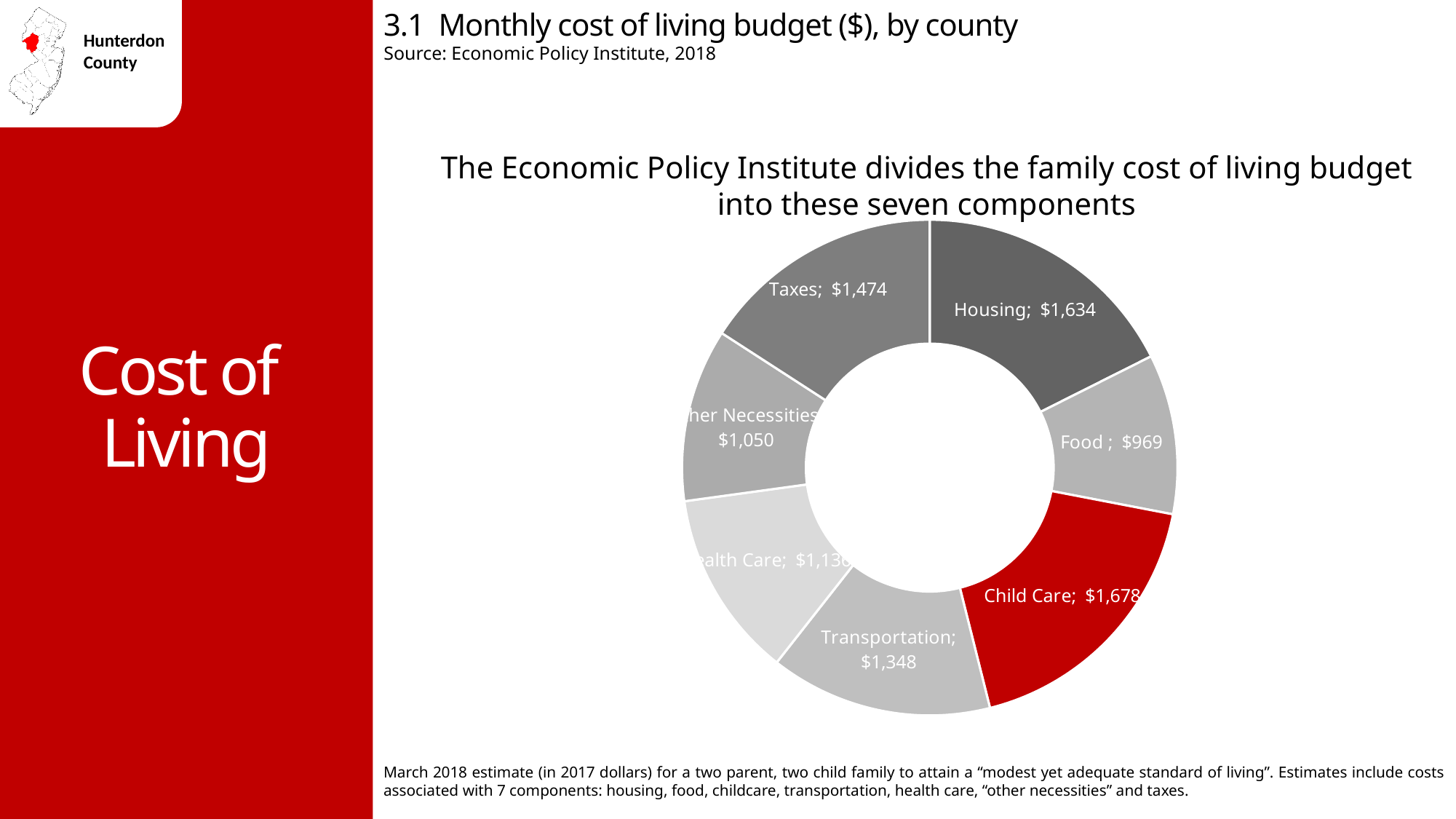
What is the monthly cost for Housing? $1,634 What is the monthly cost for Transportation? $1,348 Which component has the highest monthly cost? Child Care What is the difference between the Housing and Food monthly costs? $665 What is the monthly cost for Child Care? $1,678 Which is larger, the monthly cost for Taxes or for Transportation? Taxes Which component has the lowest monthly cost? Food What is the monthly cost for Food? $969 What is the monthly cost for Taxes? $1,474 How many components (slices) does the chart show? 7 What kind of chart is shown on the slide? doughnut chart Which component is shown in red on the chart? Child Care